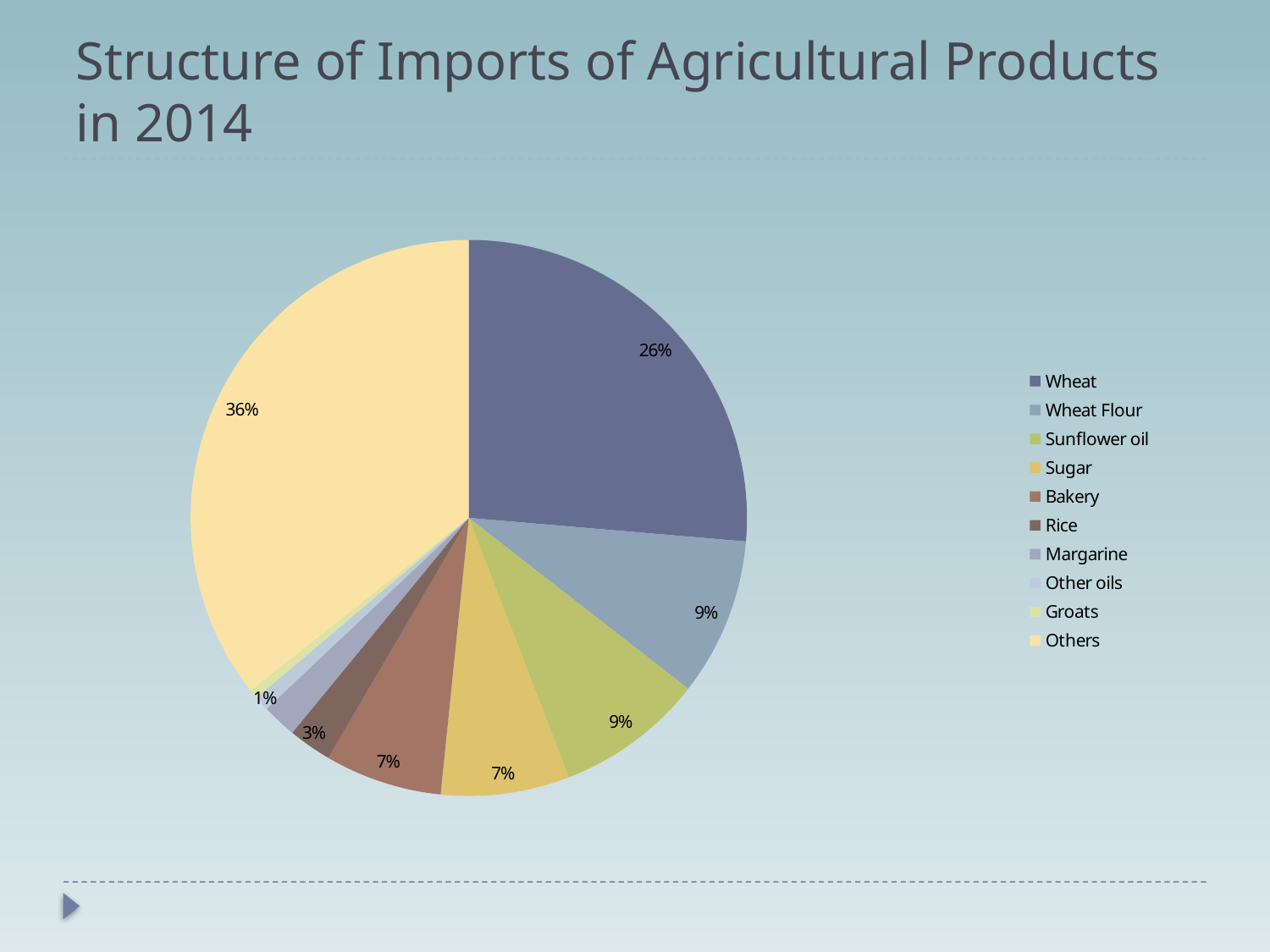
What is the difference in percentage points between the Others slice and the Wheat slice? 10 Which legend entry is listed first? Wheat Which is larger, the Wheat slice or the Wheat Flour slice? Wheat How many categories does the legend list? 10 What is the title of the slide? Structure of Imports of Agricultural Products in 2014 What percentage is shown for Sugar? 7% What percentage is shown for Wheat Flour? 9% What kind of chart is shown on the slide? Pie chart What share of the pie does Wheat account for? 26% Which is larger, the Sunflower oil slice or the Bakery slice? Sunflower oil Which category has the largest slice of the pie? Others What is the value shown for the Others slice? 36%